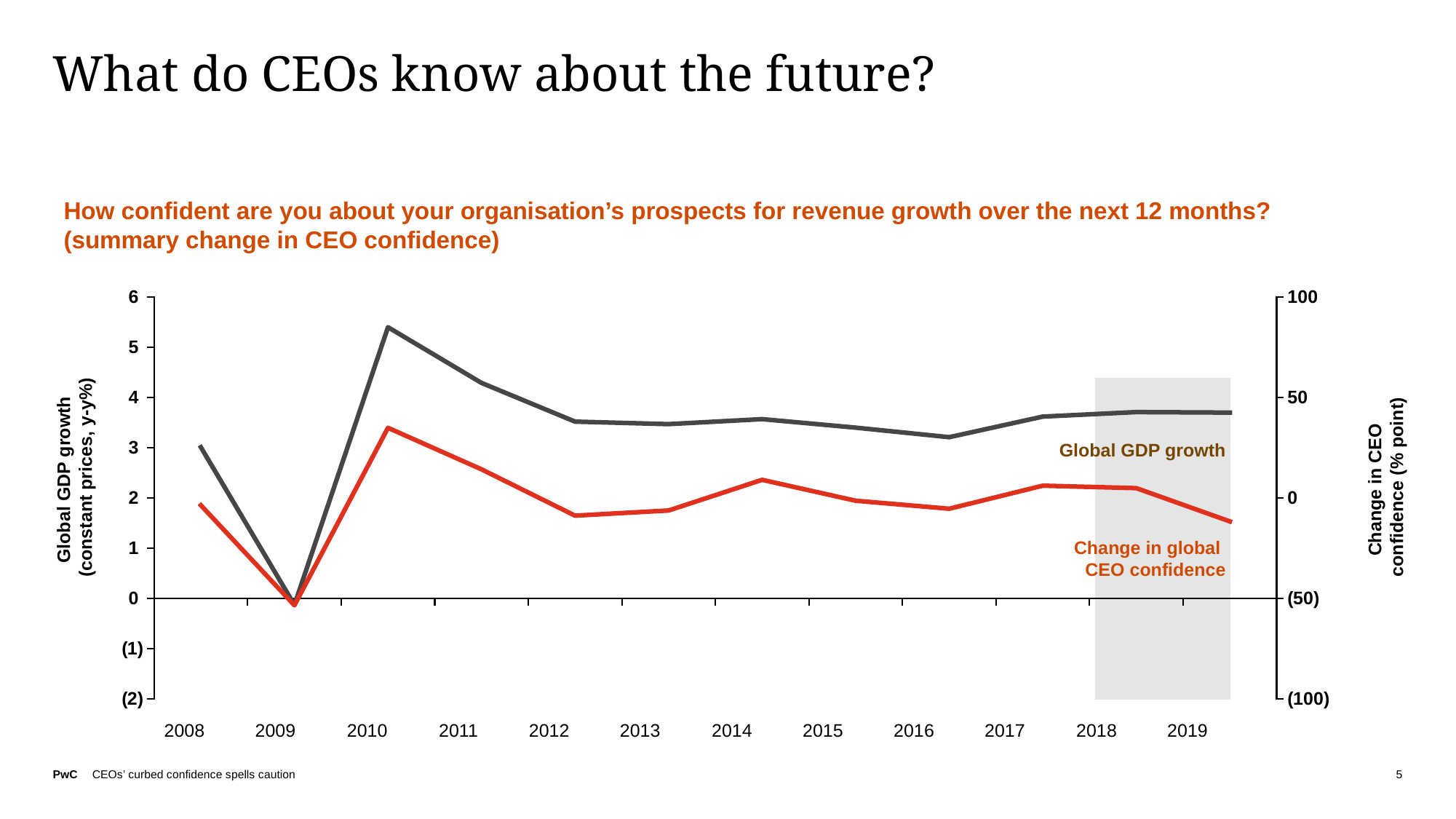
In which year is the Change in global CEO confidence lowest? 2009 Which year has the larger Global GDP growth, 2008 or 2010? 2010 What kind of chart is shown on the slide? line chart Is the Global GDP growth value for 2012 greater or less than 4? less How many years are shown along the x axis of the chart? 12 Is the Change in global CEO confidence for 2019 greater or less than 0? less How many series are plotted on the chart? 2 Is the Global GDP growth value for 2010 greater or less than 5? greater What is the label of the left vertical axis of the chart? Global GDP growth (constant prices, y-y%) In which year is Global GDP growth lowest? 2009 In which year is Global GDP growth highest? 2010 Does Global GDP growth rise or fall from 2010 to 2012? fall